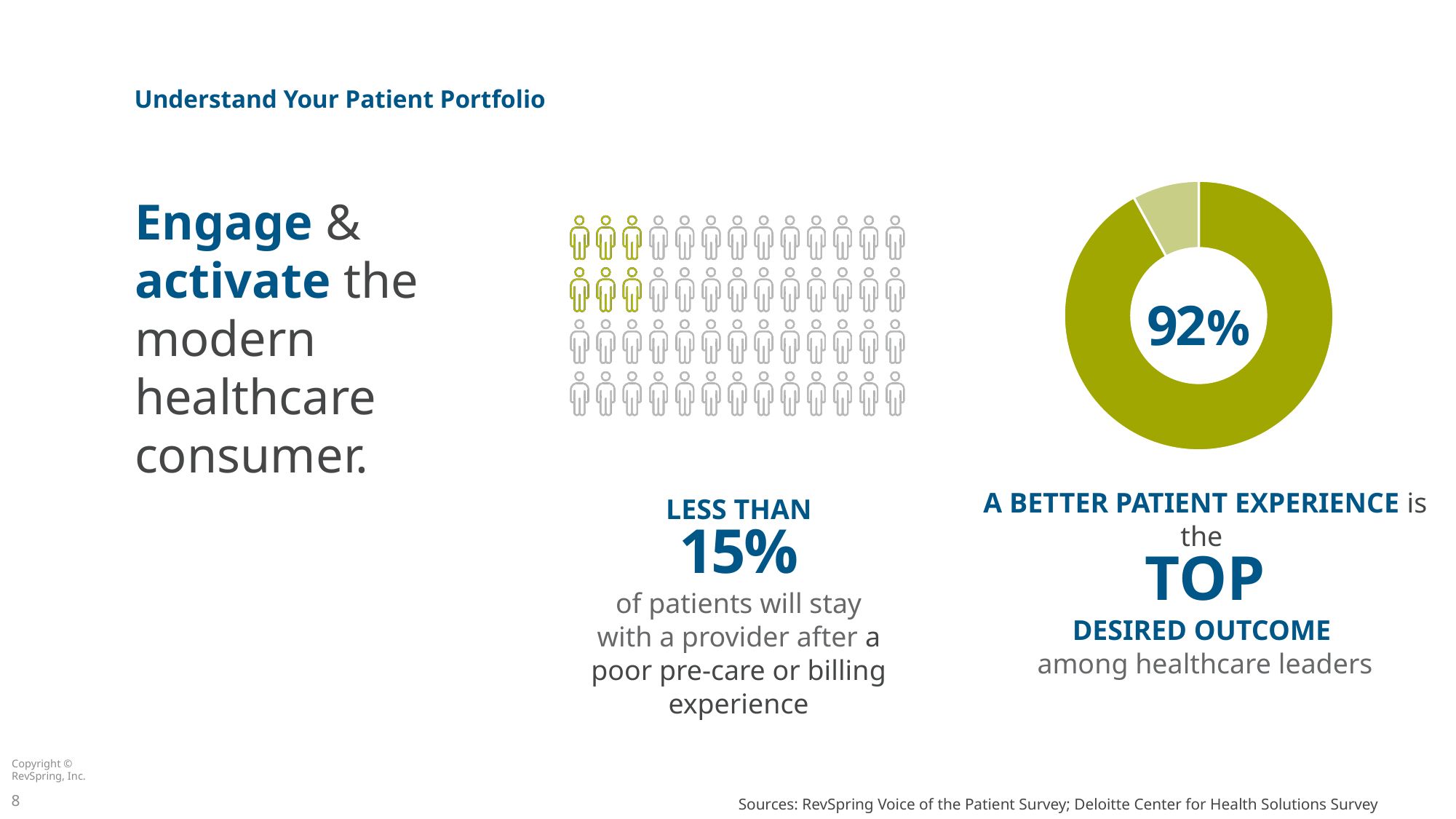
What share of the donut chart does the small light green segment represent? 8% In the pictogram of people icons, how many icons are highlighted in green? 6 What percentage is printed in the centre of the donut chart on the right? 92% In the donut chart, which segment is larger, the dark green one or the light green one? The dark green one How many rows of people icons are in the pictogram? 4 What kind of chart is shown on the right side of the slide? Donut chart According to the text under the donut chart, what does the 92% figure represent? Healthcare leaders for whom a better patient experience is the top desired outcome What share of the donut chart does the large dark green segment represent? 92% Is the value shown in the donut chart greater or less than 50%? greater How many segments does the donut chart have? 2 What is the title at the top of the slide? Understand Your Patient Portfolio What percentage is stated beneath the pictogram of people icons? Less than 15%